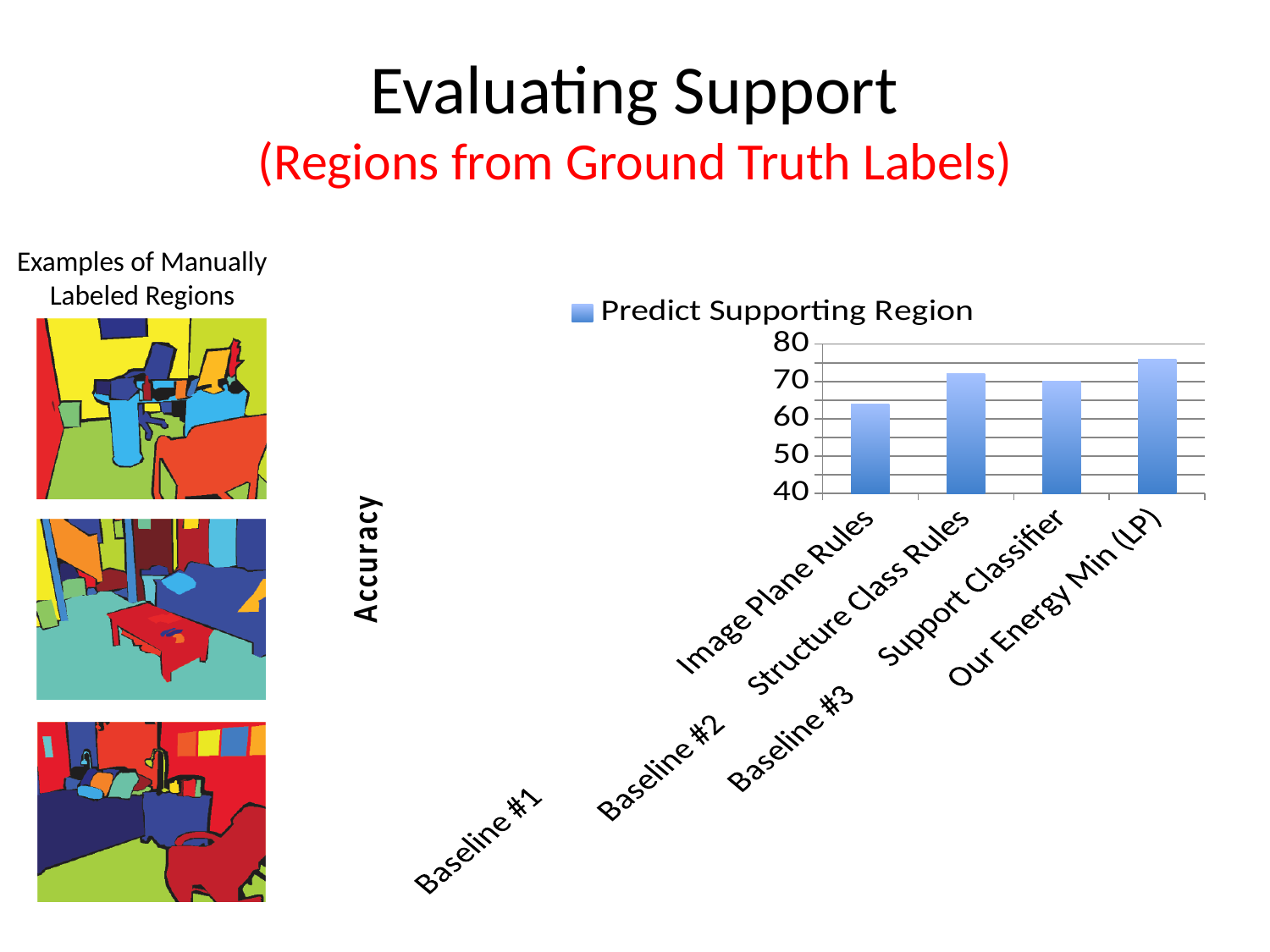
What is the label on the vertical axis of the chart? Accuracy How many series does the chart legend list? 1 Which category has the lowest accuracy in the chart? Baseline #1 Image Plane Rules Is the value for Our Energy Min (LP) greater or less than 80? less What kind of chart is shown on the slide? bar chart How many bars (categories) are plotted in the chart? 4 Which is larger, the value for Baseline #1 Image Plane Rules or the value for Our Energy Min (LP)? Our Energy Min (LP) Is the value for Baseline #1 Image Plane Rules greater or less than 70? less Is the value for Baseline #1 Image Plane Rules greater or less than 60? greater What is the series name shown in the chart legend? Predict Supporting Region Which category has the highest accuracy in the chart? Our Energy Min (LP)